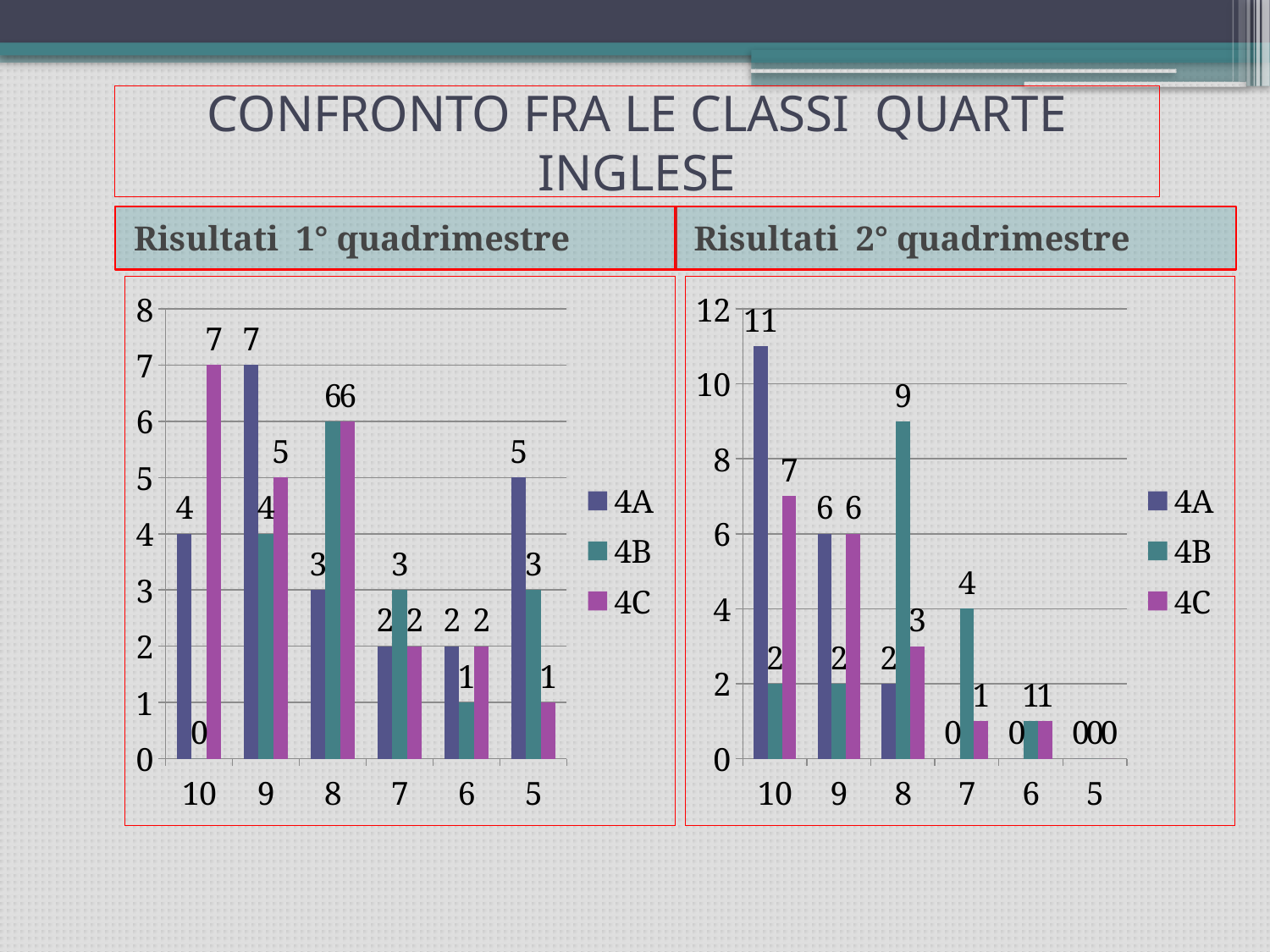
In the 'Risultati 1° quadrimestre' chart, how many categories are shown on the x axis? 6 In the 'Risultati 2° quadrimestre' chart, what is the value for 4A at category 10? 11 What type of chart is the 'Risultati 1° quadrimestre' chart? Bar chart In the 'Risultati 1° quadrimestre' chart, which category has the highest value for 4A? 9 In the 'Risultati 1° quadrimestre' chart, what is the value for 4B at category 8? 6 In the 'Risultati 2° quadrimestre' chart, which is larger at category 7: 4B or 4C? 4B In the 'Risultati 1° quadrimestre' chart, what is the difference between 4A and 4B at category 5? 2 In the 'Risultati 2° quadrimestre' chart, what is the value for 4B at category 8? 9 In the 'Risultati 2° quadrimestre' chart, which category has the lowest value for 4B? 5 How many series does the legend of the 'Risultati 2° quadrimestre' chart list? 3 In the 'Risultati 2° quadrimestre' chart, what is the difference between 4A and 4C at category 10? 4 In the 'Risultati 1° quadrimestre' chart, what is the value for 4C at category 10? 7